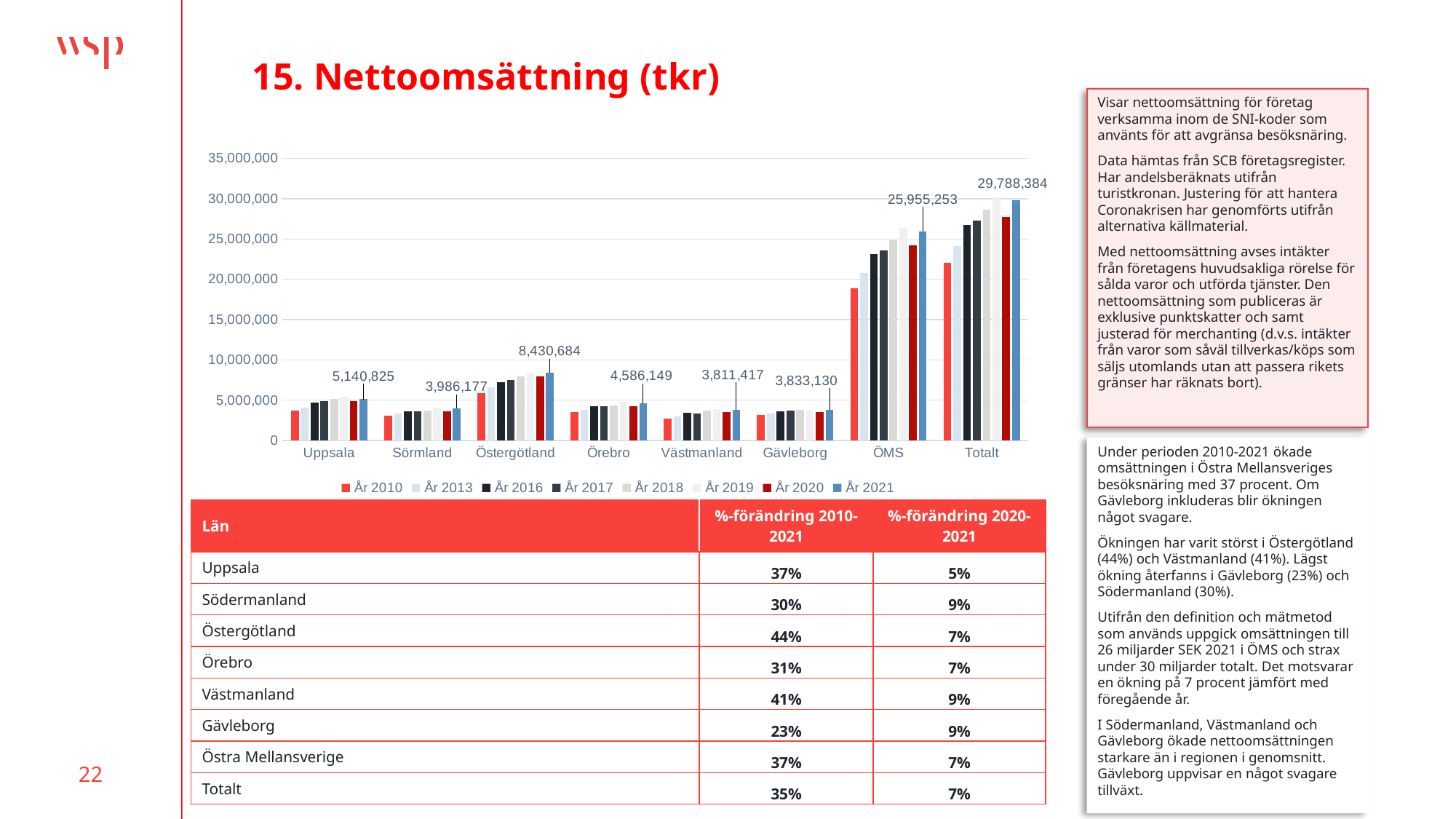
What is the difference between the År 2021 values for Totalt and ÖMS? 3,833,131 What kind of chart is shown on the slide? bar chart Is the År 2010 value for Totalt greater or less than 20,000,000? greater What is the År 2021 value for ÖMS? 25,955,253 How many categories are shown on the x axis of the chart? 8 What is the År 2021 value for Totalt? 29,788,384 Among the individual län (excluding ÖMS and Totalt), which has the highest År 2021 value? Östergötland Among the individual län (excluding ÖMS and Totalt), which has the lowest labelled År 2021 value? Västmanland Which has the larger År 2021 value, Örebro or Sörmland? Örebro How many series does the chart legend list? 8 What is the År 2021 value for Uppsala? 5,140,825 What is the År 2021 value for Östergötland? 8,430,684